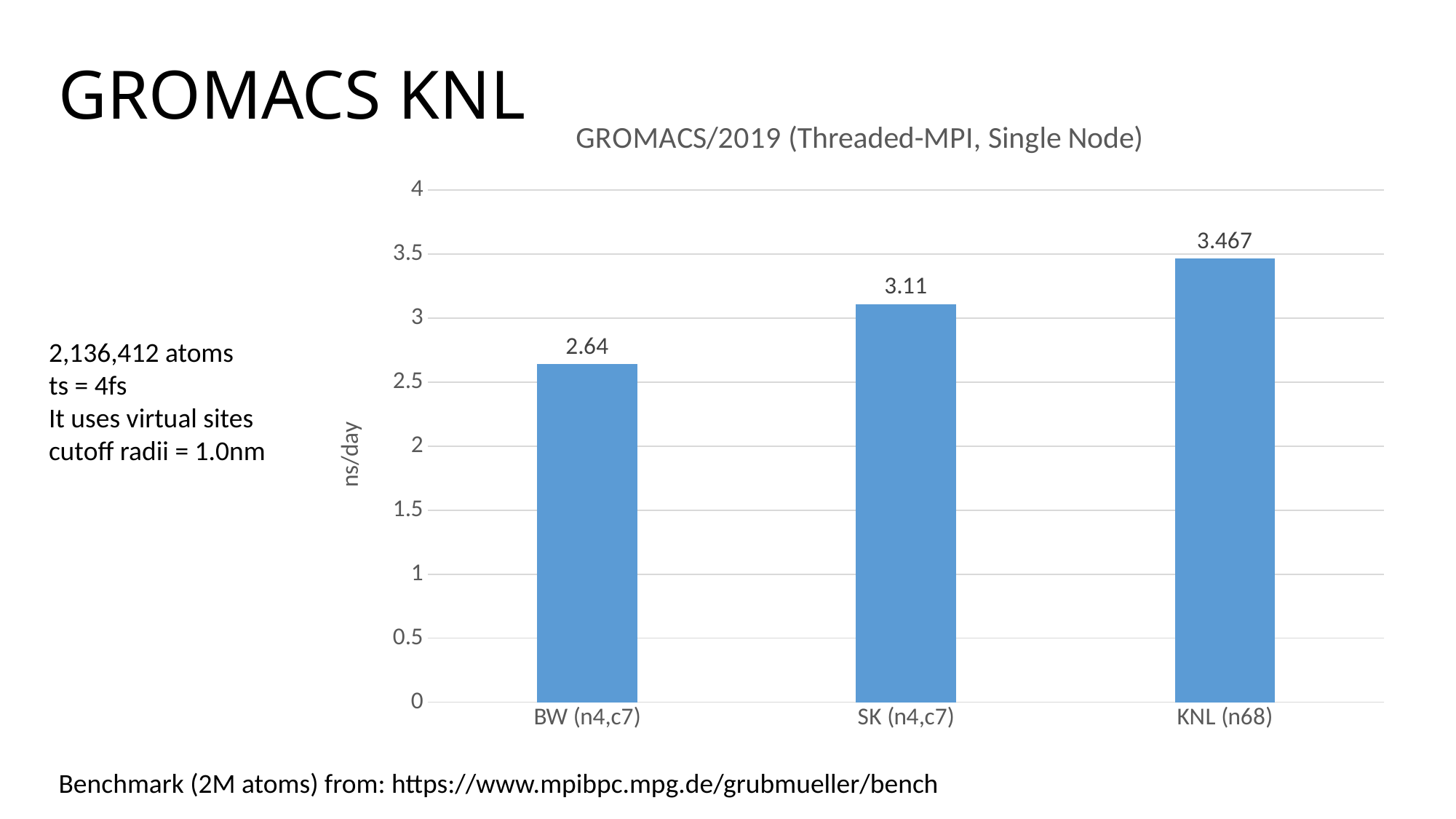
Which configuration has the lowest ns/day? BW (n4,c7) What is the ns/day value for SK (n4,c7)? 3.11 What kind of chart is shown on the slide? Bar chart What is the difference in ns/day between KNL (n68) and BW (n4,c7)? 0.827 Which has a higher ns/day, SK (n4,c7) or KNL (n68)? KNL (n68) What is the ns/day value for KNL (n68)? 3.467 Which configuration has the highest ns/day? KNL (n68) What is the title of the chart? GROMACS/2019 (Threaded-MPI, Single Node) What is the difference in ns/day between SK (n4,c7) and BW (n4,c7)? 0.47 What is the ns/day value for BW (n4,c7)? 2.64 How many configurations are shown in the chart? 3 Is the value for SK (n4,c7) greater or less than 3? greater